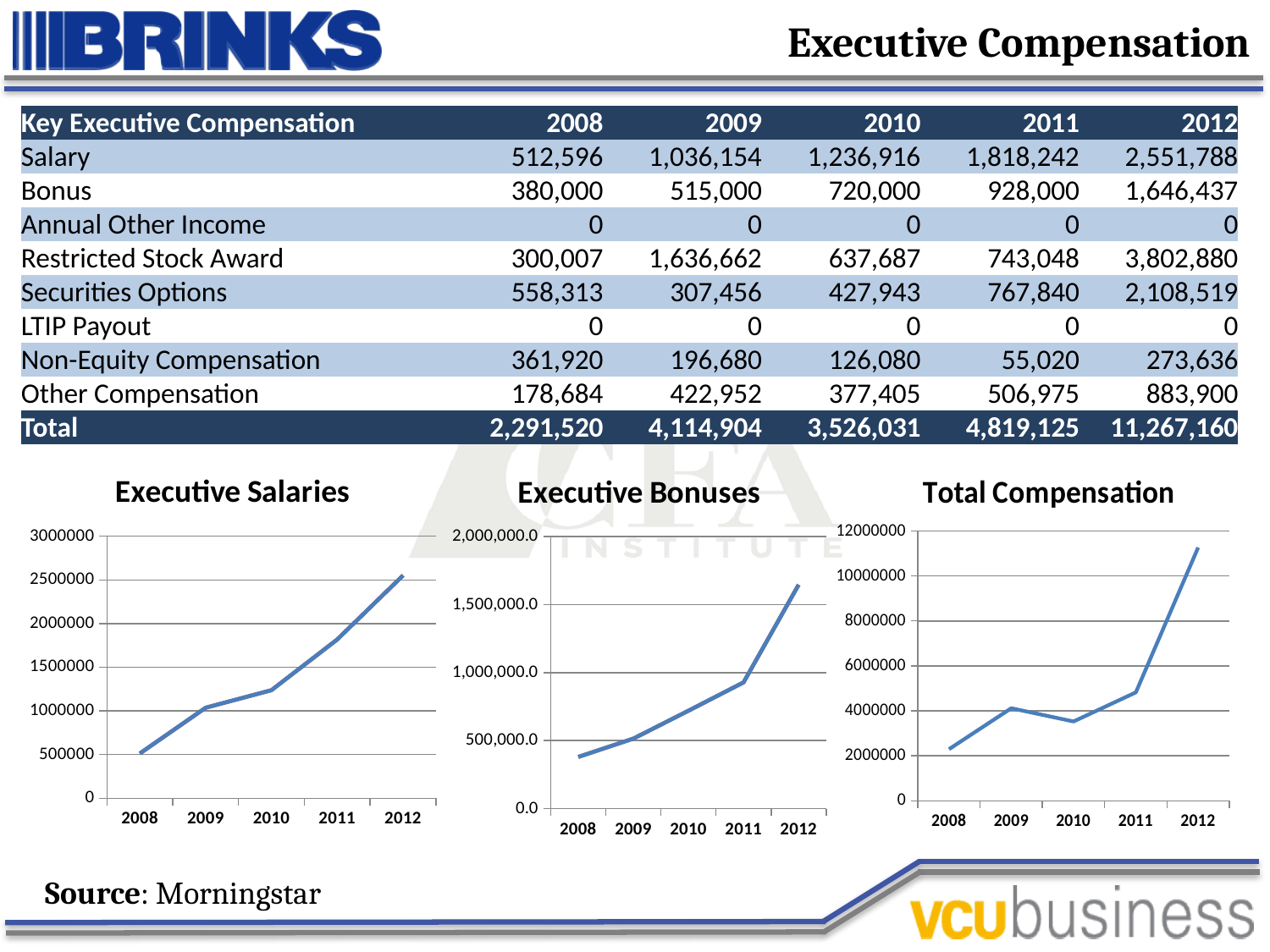
On the Total Compensation chart, which year has the lowest value? 2008 On the Total Compensation chart, what is the total compensation for 2012? 11,267,160 On the Executive Salaries chart, what is the salary value for 2012? 2,551,788 On the Executive Salaries chart, is the value for 2010 greater or less than 1500000? less What is the title of the rightmost chart on the slide? Total Compensation On the Executive Salaries chart, do the values rise or fall from 2008 to 2012? rise How many data points are plotted on the Executive Bonuses chart? 5 On the Executive Bonuses chart, is the value for 2012 greater or less than 1,500,000.0? greater On the Total Compensation chart, which year has the larger value, 2009 or 2010? 2009 On the Total Compensation chart, which year has the highest value? 2012 What kind of chart is the Executive Salaries chart? line chart On the Executive Bonuses chart, by how much did the bonus increase from 2011 to 2012? 718,437